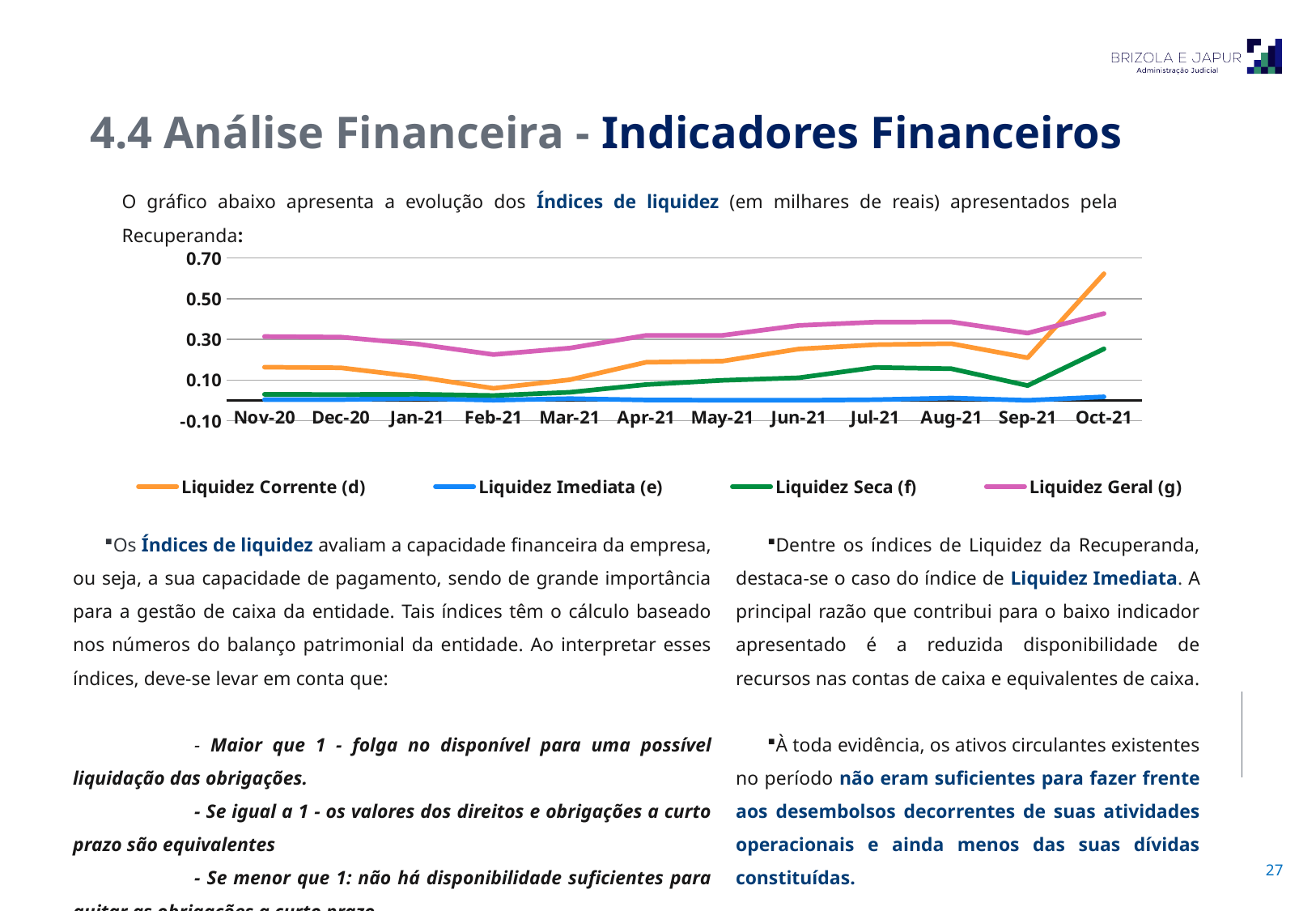
In which month is Liquidez Corrente (d) at its lowest? Feb-21 How many months are plotted along the x axis? 12 In which month does Liquidez Seca (f) reach its highest value? Oct-21 How many series does the legend list? 4 Which series is shown in orange in the legend? Liquidez Corrente (d) Is the value for Liquidez Corrente (d) in Oct-21 greater or less than 0.50? greater What kind of chart is shown on the slide? Line chart In which month is Liquidez Geral (g) at its lowest? Feb-21 Is the value for Liquidez Geral (g) in Oct-21 greater or less than 0.50? less In which month does Liquidez Corrente (d) reach its highest value? Oct-21 Which is higher in Nov-20, Liquidez Geral (g) or Liquidez Corrente (d)? Liquidez Geral (g) Is the value for Liquidez Imediata (e) in Jul-21 greater or less than 0.10? less